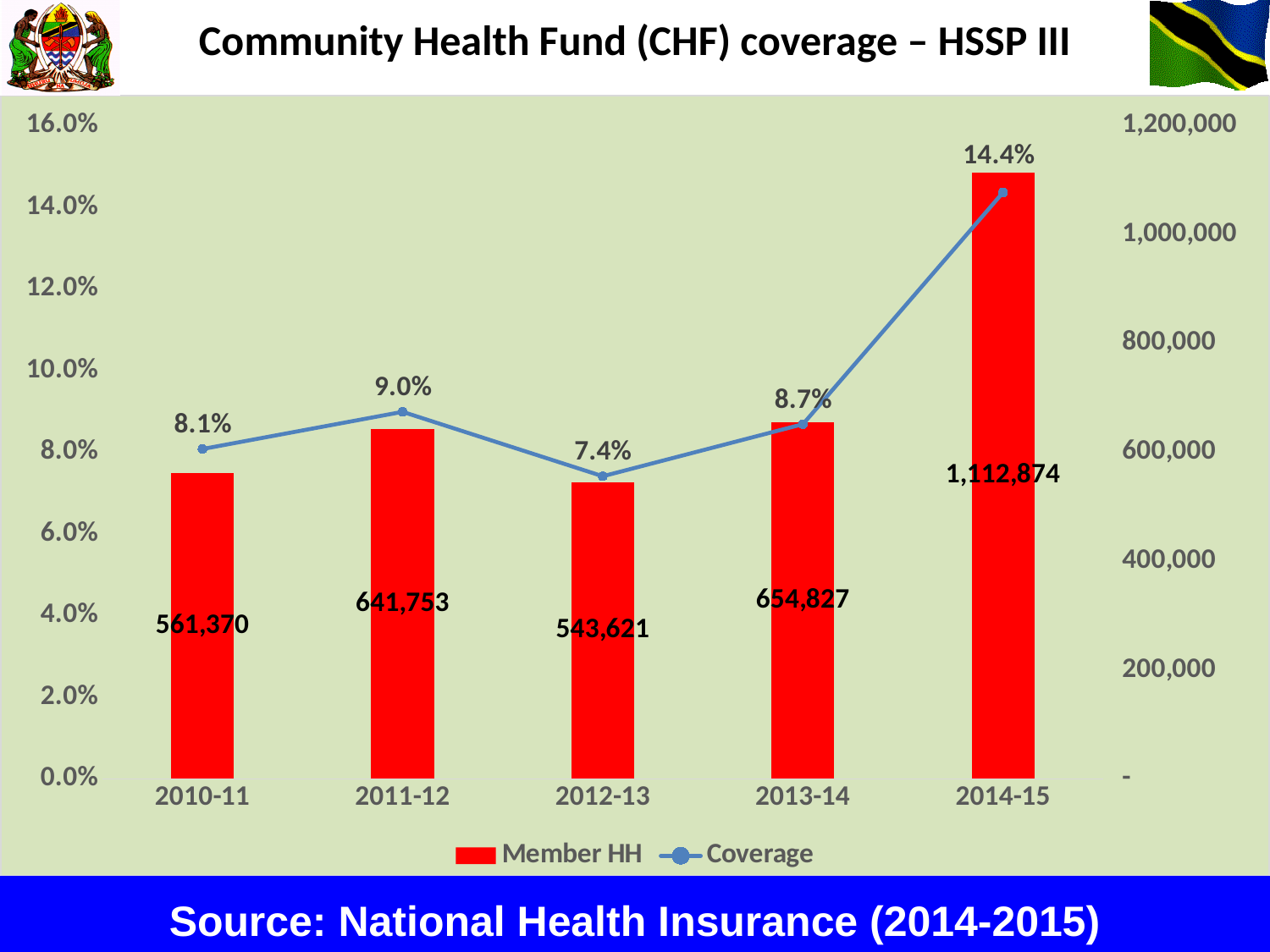
How many series does the legend list? 2 Which year has the highest Member HH value? 2014-15 What is the Coverage value for 2014-15? 14.4% What is the difference in Member HH between 2013-14 and 2012-13? 111,206 What is the title of the chart? Community Health Fund (CHF) coverage – HSSP III What is the Member HH value for 2012-13? 543,621 Which is larger, the Coverage for 2011-12 or for 2013-14? 2011-12 What kind of chart is used for the Member HH series? bar chart How many years are shown on the x axis? 5 Which year has the lowest Coverage value? 2012-13 What is the Member HH value for 2011-12? 641,753 Is the Member HH value for 2014-15 greater or less than 1,000,000? greater